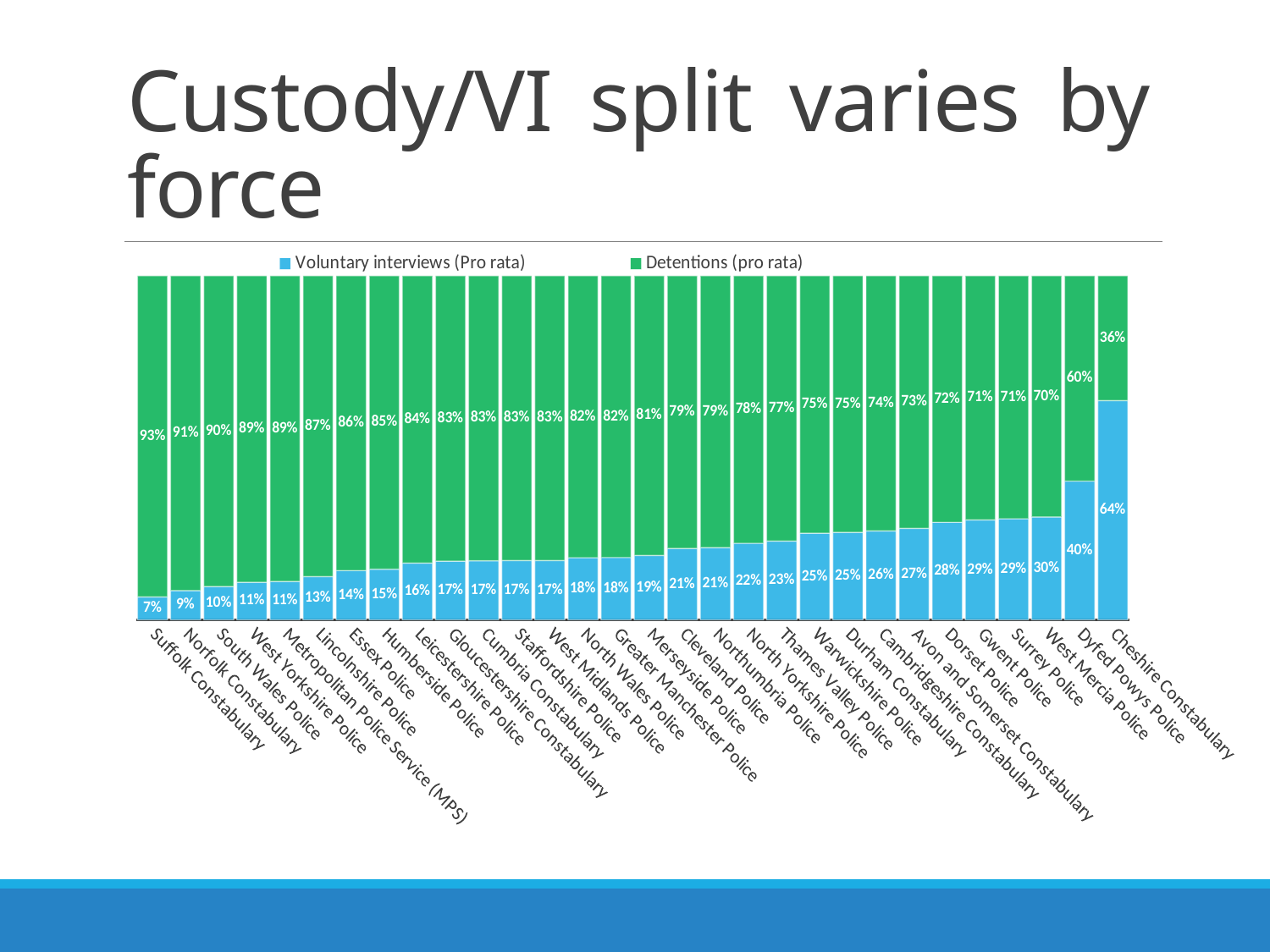
What is the Voluntary interviews (Pro rata) value for Cheshire Constabulary? 64% Which force has the highest Voluntary interviews (Pro rata) share? Cheshire Constabulary How many series does the legend list? 2 What is the difference between the Detentions (pro rata) value for Dyfed Powys Police and its Voluntary interviews (Pro rata) value? 20% Do the Voluntary interviews (Pro rata) values rise or fall from left to right along the x axis? Rise Which is larger for Cheshire Constabulary: Voluntary interviews (Pro rata) or Detentions (pro rata)? Voluntary interviews (Pro rata) What is the Voluntary interviews (Pro rata) value for Dyfed Powys Police? 40% Which force has the lowest Voluntary interviews (Pro rata) share? Suffolk Constabulary Which force has the lowest Detentions (pro rata) share? Cheshire Constabulary How many forces are shown on the x axis of the chart? 30 What kind of chart is shown on the slide? Stacked bar chart What is the Detentions (pro rata) value for Suffolk Constabulary? 93%